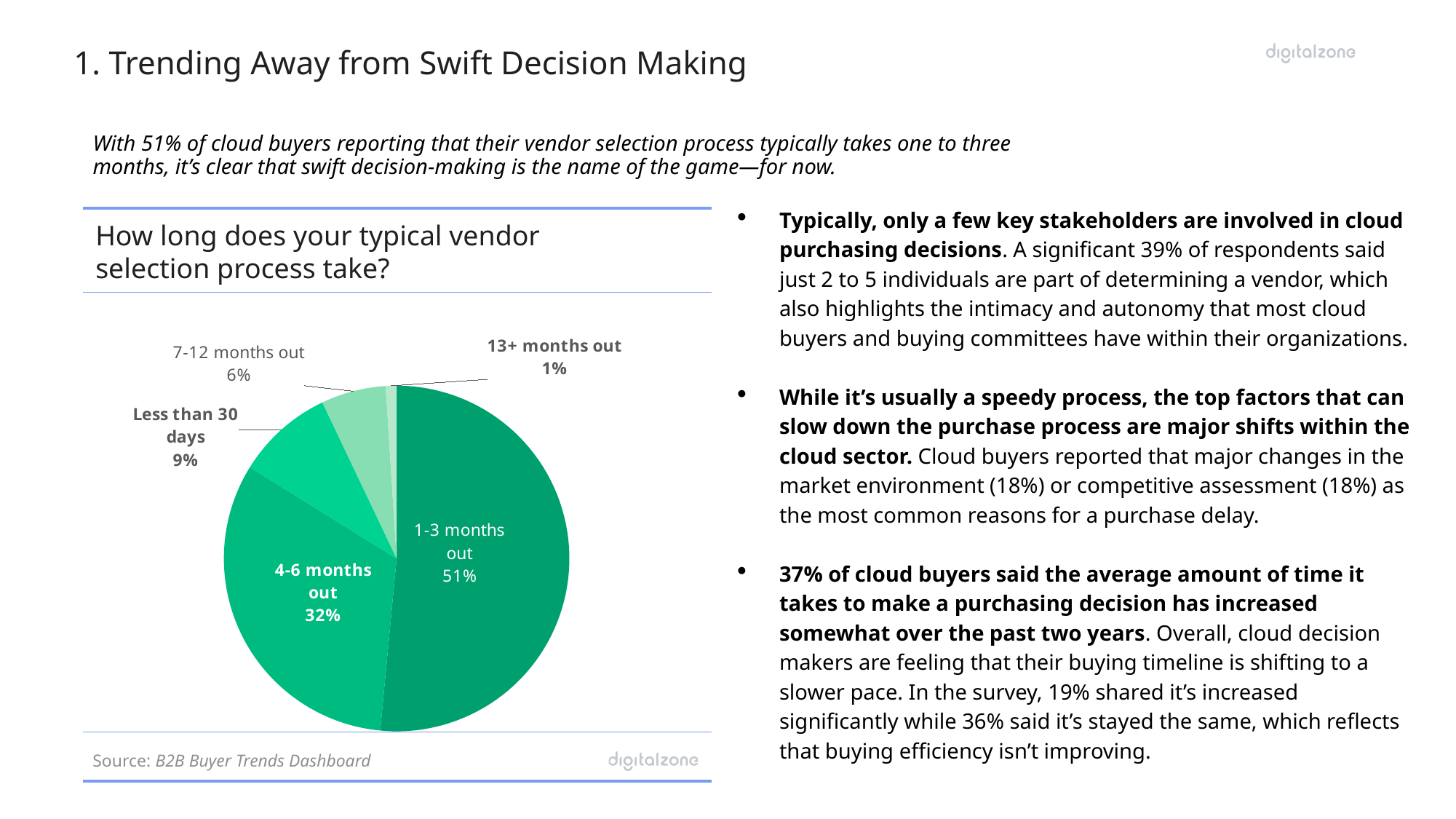
What kind of chart is shown on the slide? Pie chart What is the value for the '7-12 months out' slice? 6% What percentage of respondents selected '4-6 months out'? 32% Which is larger: the share for 'Less than 30 days' or the share for '7-12 months out'? Less than 30 days What is the title of the pie chart? How long does your typical vendor selection process take? What share of respondents said their vendor selection process takes 1-3 months? 51% What percentage of respondents said 'Less than 30 days'? 9% What is the difference in percentage points between '1-3 months out' and '4-6 months out'? 19% Which category has the smallest share of the pie? 13+ months out How many categories are shown in the pie chart? 5 What is the value for the '13+ months out' slice? 1% Which category has the largest share of the pie? 1-3 months out